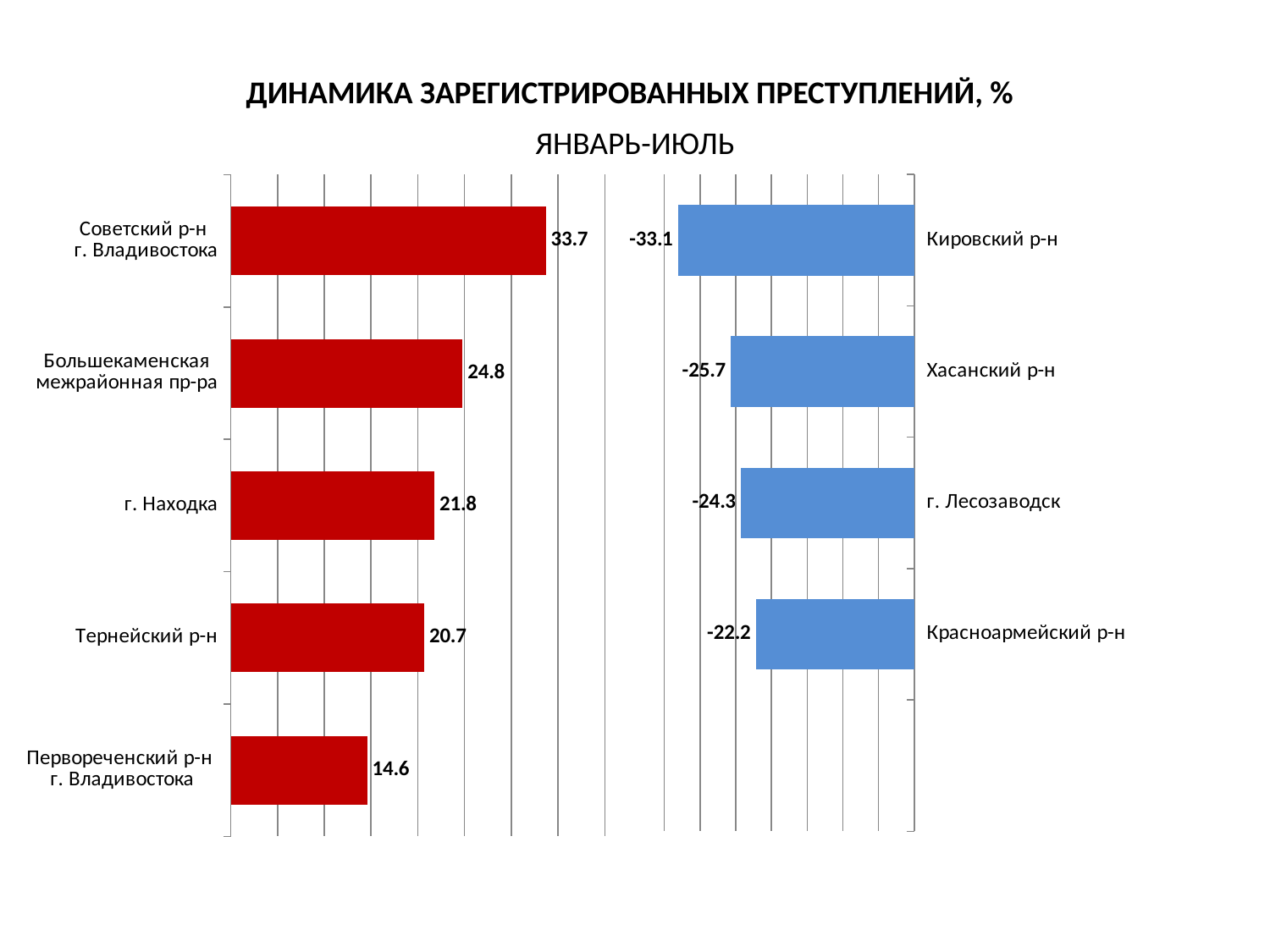
On the left (red) chart, what is the difference between the values for Советский р-н г. Владивостока and Большекаменская межрайонная пр-ра? 8.9 On the right (blue) chart, what is the value for Хасанский р-н? -25.7 On the left (red) chart, what is the value for Тернейский р-н? 20.7 On the left (red) chart, what is the value for г. Находка? 21.8 On the right (blue) chart, which has the larger value, г. Лесозаводск or Хасанский р-н? г. Лесозаводск How many categories are shown on the left (red) chart? 5 On the left (red) chart, which category has the lowest value? Первореченский р-н г. Владивостока On the left (red) chart, which category has the highest value? Советский р-н г. Владивостока On the right (blue) chart, which category has the lowest (most negative) value? Кировский р-н How many categories are shown on the right (blue) chart? 4 On the right (blue) chart, what is the value for Красноармейский р-н? -22.2 What type of chart is used on this slide? Bar chart